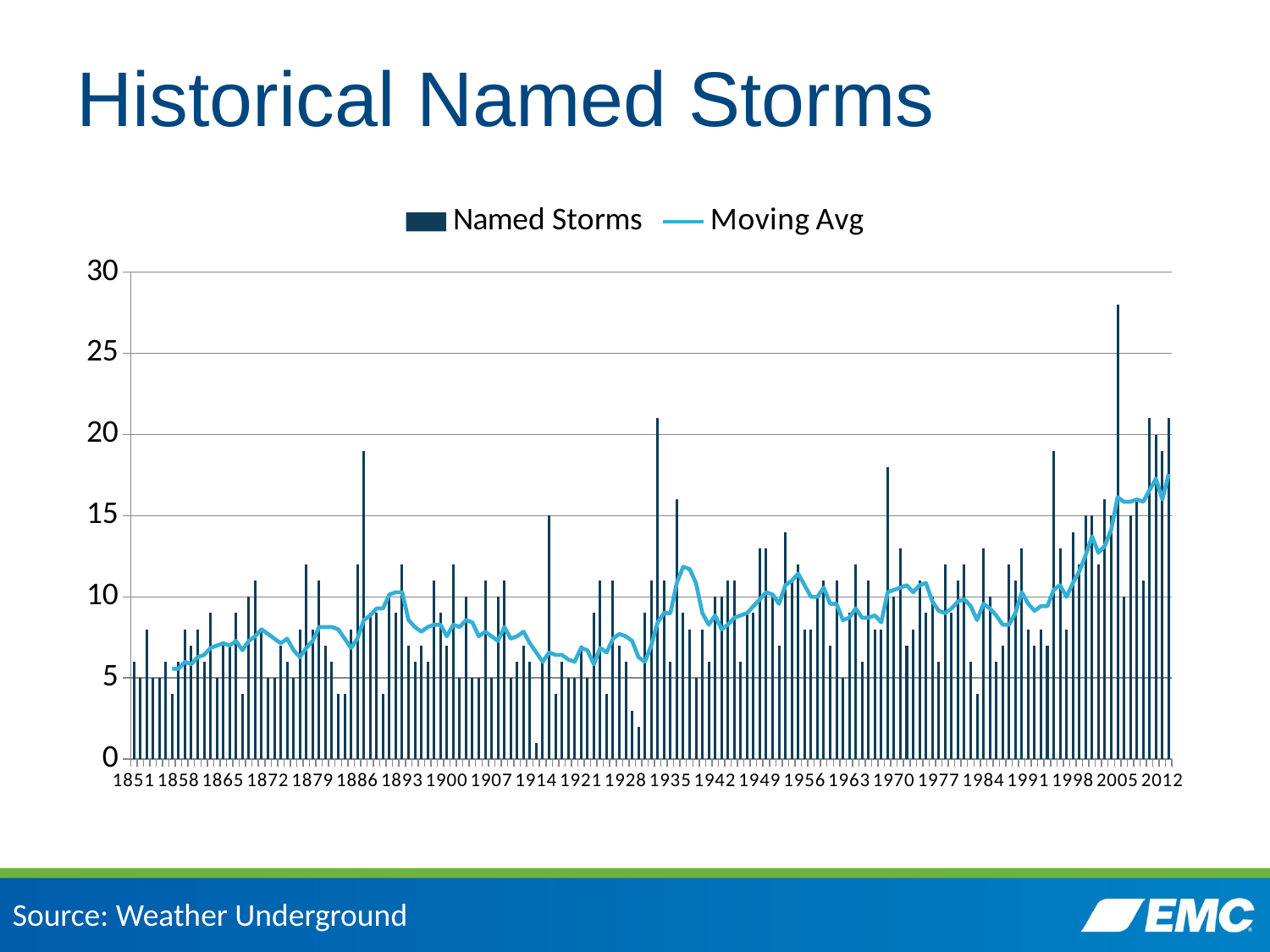
Is the Moving Avg value at 1914 greater or less than 10? less What is the title of the slide containing the chart? Historical Named Storms What kind of chart is shown on the slide? Bar chart with a line What are the two series named in the legend? Named Storms and Moving Avg Is the number of named storms for 1914 greater or less than 5? less Is the number of named storms for 2012 greater or less than 15? greater Does the Moving Avg line generally rise or fall from 1851 to 2012? rise Which year has the highest number of named storms? 2005 How many series does the legend list? 2